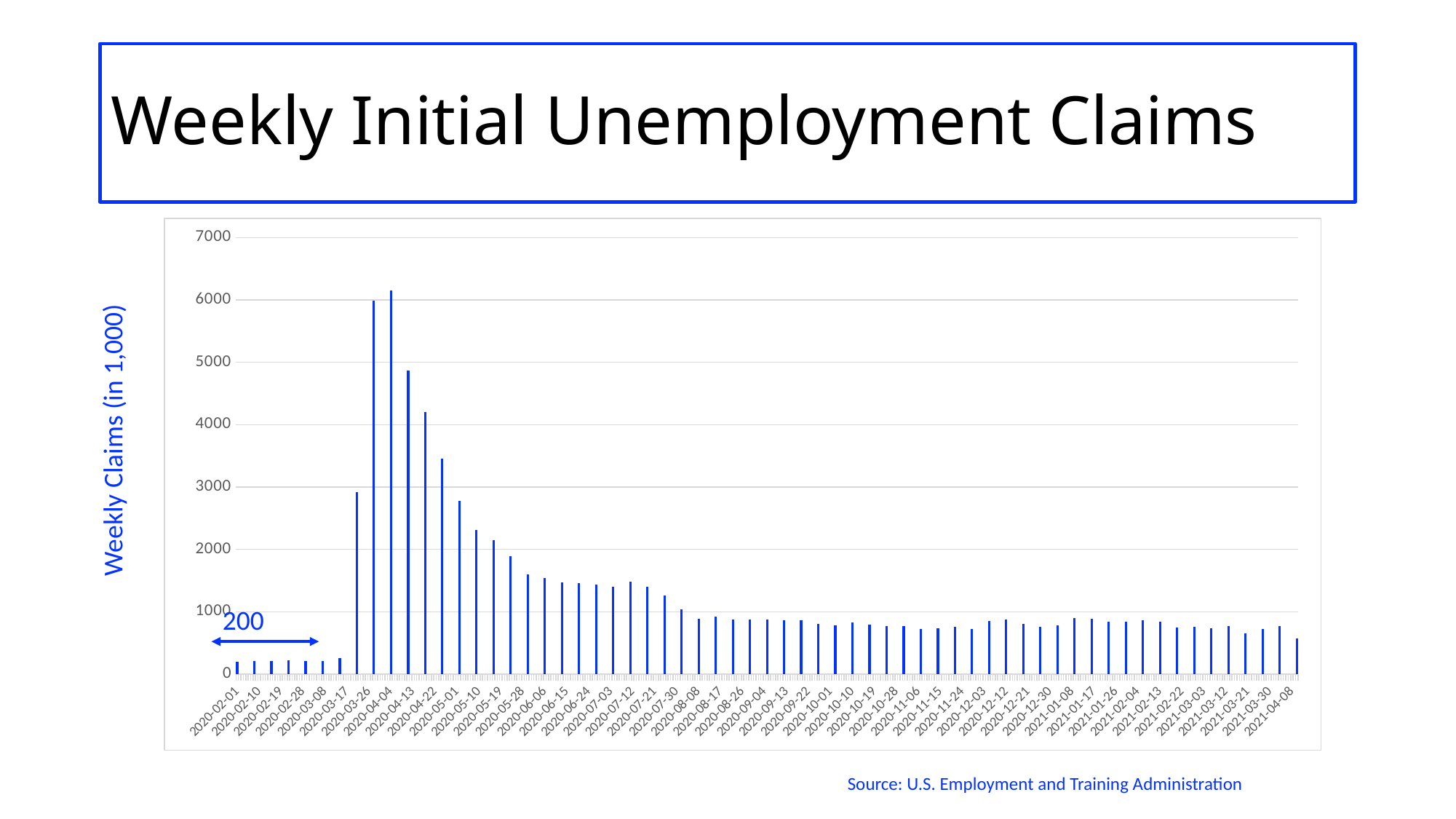
Is the value for 2021-04-08 greater or less than 1000? less Do the values rise or fall along the x axis from 2020-04-04 to 2020-08-08? fall What is the title of the slide's chart? Weekly Initial Unemployment Claims What is the label on the vertical axis of the chart? Weekly Claims (in 1,000) Is the value for 2020-02-01 greater or less than 1000? less Is the value for 2020-05-10 greater or less than 3000? less What kind of chart is shown on the slide? bar chart Which is larger, the value for 2020-04-13 or the value for 2020-05-19? 2020-04-13